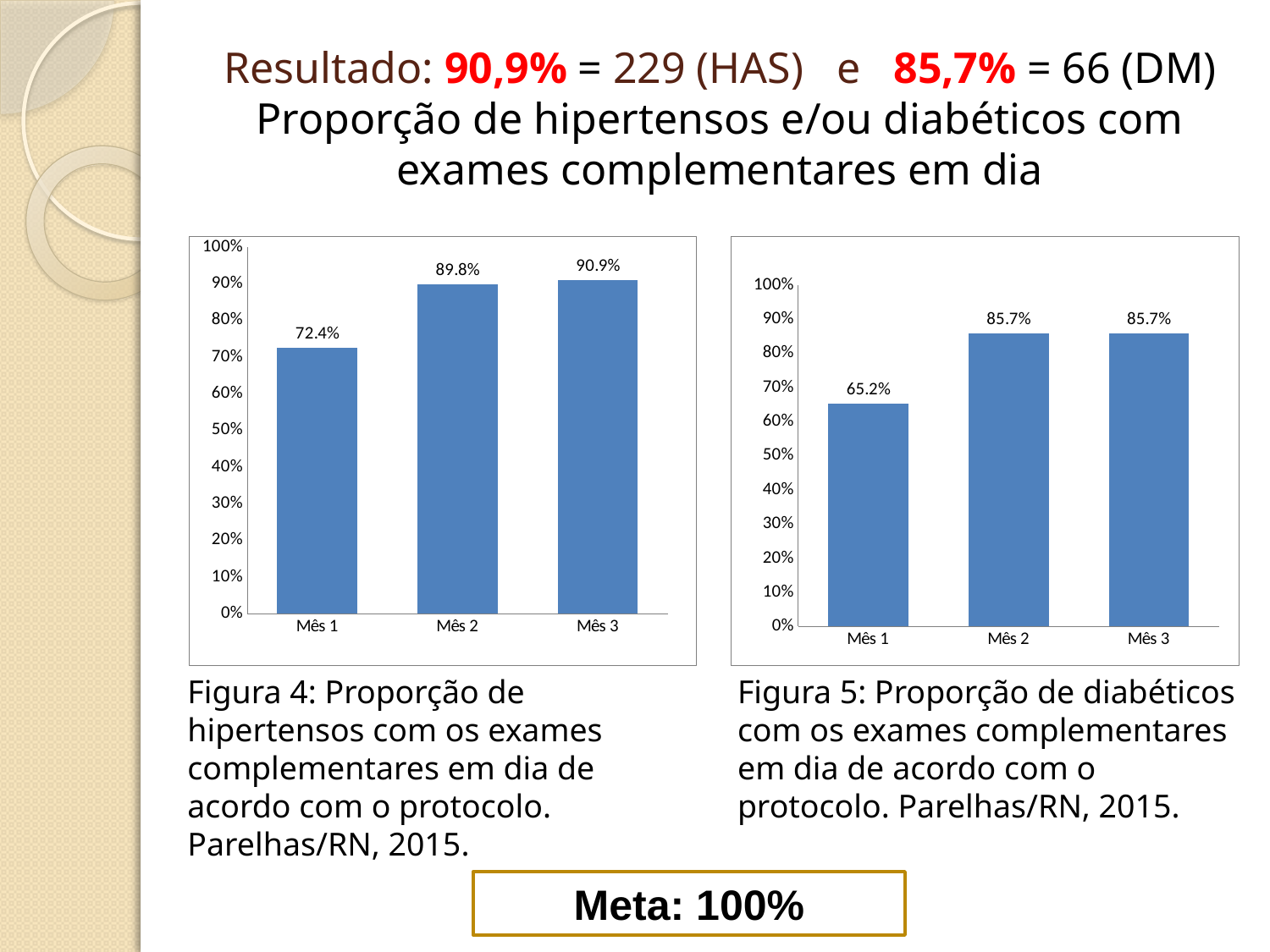
In the left chart (Figura 4), which month has the highest value? Mês 3 In the left chart (Figura 4), do the values rise or fall from Mês 1 to Mês 3? Rise In the left chart (Figura 4), what is the value for Mês 1? 72.4% Which is larger: the Mês 1 value in the left chart (Figura 4) or the Mês 1 value in the right chart (Figura 5)? Left chart (Figura 4), 72.4% In the right chart (Figura 5), what is the value for Mês 1? 65.2% What kind of chart is the right chart (Figura 5)? Bar chart In the right chart (Figura 5), what is the value for Mês 2? 85.7% In the left chart (Figura 4), what is the value for Mês 3? 90.9% How many months are shown on the x axis of the left chart (Figura 4)? 3 In the right chart (Figura 5), which month has the lowest value? Mês 1 In the right chart (Figura 5), what is the difference between the values for Mês 2 and Mês 1? 20.5% In the left chart (Figura 4), what is the difference between the values for Mês 3 and Mês 1? 18.5%